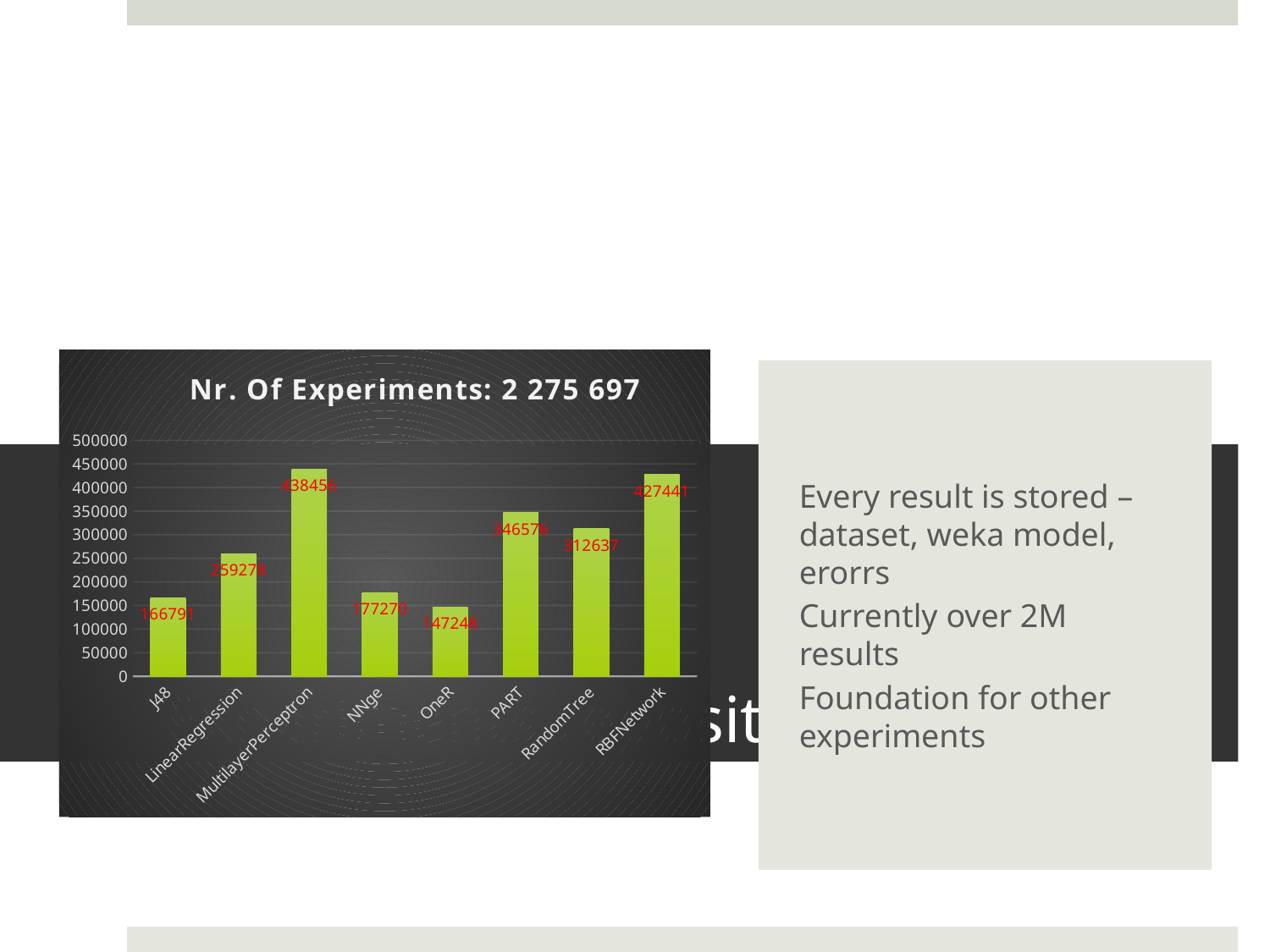
How many categories are shown on the x axis? 8 What is the number of experiments for J48? 166791 Which category has the highest number of experiments? MultilayerPerceptron What is the title of the chart? Nr. Of Experiments: 2 275 697 Which category has the lowest number of experiments? OneR What is the number of experiments for PART? 346576 What is the number of experiments for OneR? 147248 What is the number of experiments for MultilayerPerceptron? 438456 What is the difference between the values for MultilayerPerceptron and RBFNetwork? 11015 Is the value for RandomTree greater or less than 300000? greater What is the difference between the values for PART and RandomTree? 33939 Which has a larger value, LinearRegression or NNge? LinearRegression